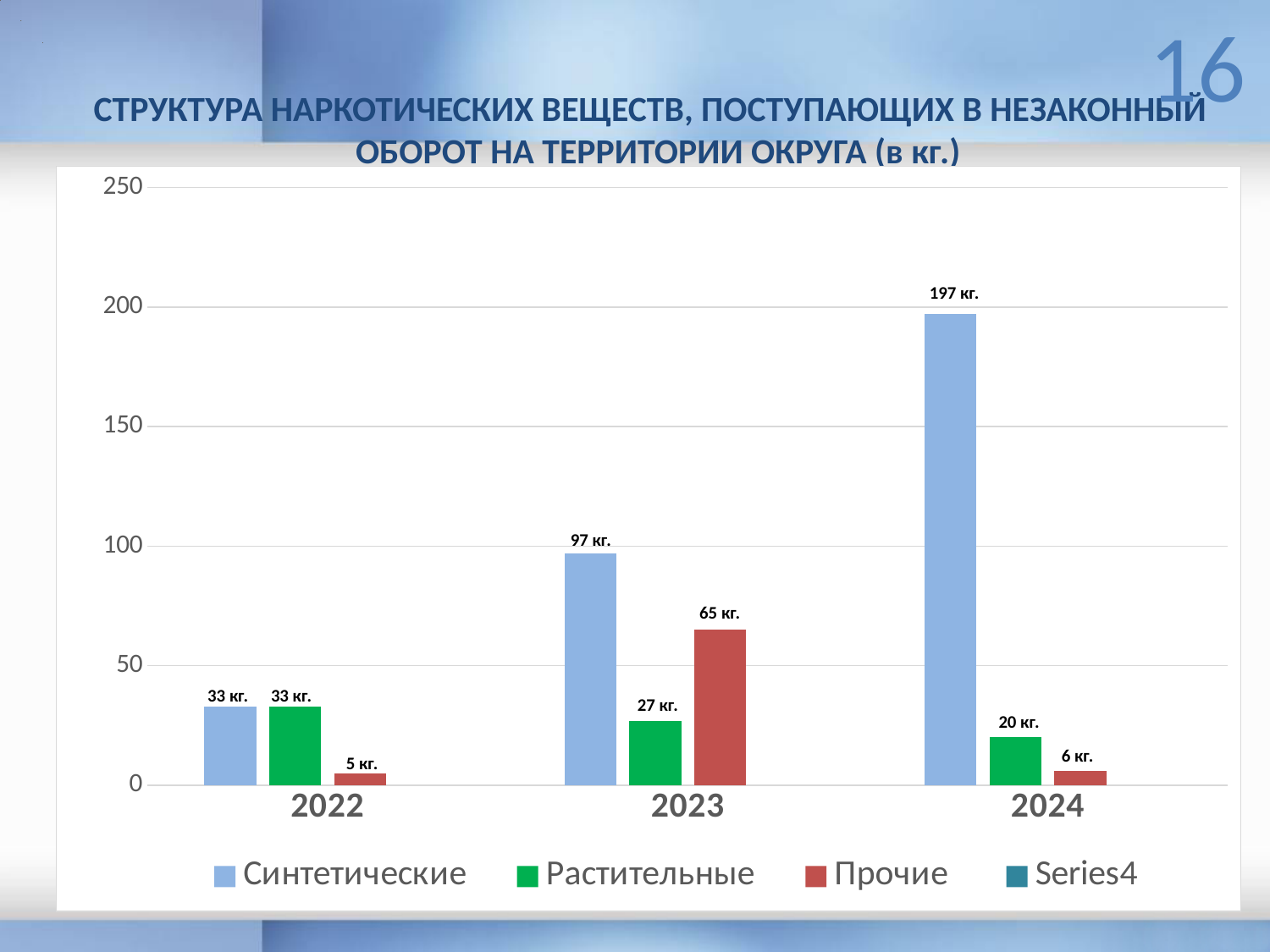
Which is larger in 2023: Растительные or Прочие? Прочие How many years are shown on the x axis? 3 What is the value for Прочие in 2023? 65 кг. In which year is the value for Синтетические highest? 2024 In which year is the value for Прочие lowest? 2022 What kind of chart is shown on the slide? bar chart Is the value for Синтетические in 2023 greater or less than 100? less What is the value for Прочие in 2022? 5 кг. What is the value for Синтетические in 2024? 197 кг. How many series does the legend list? 4 What is the difference between the Синтетические values for 2024 and 2023? 100 кг. What is the value for Растительные in 2022? 33 кг.